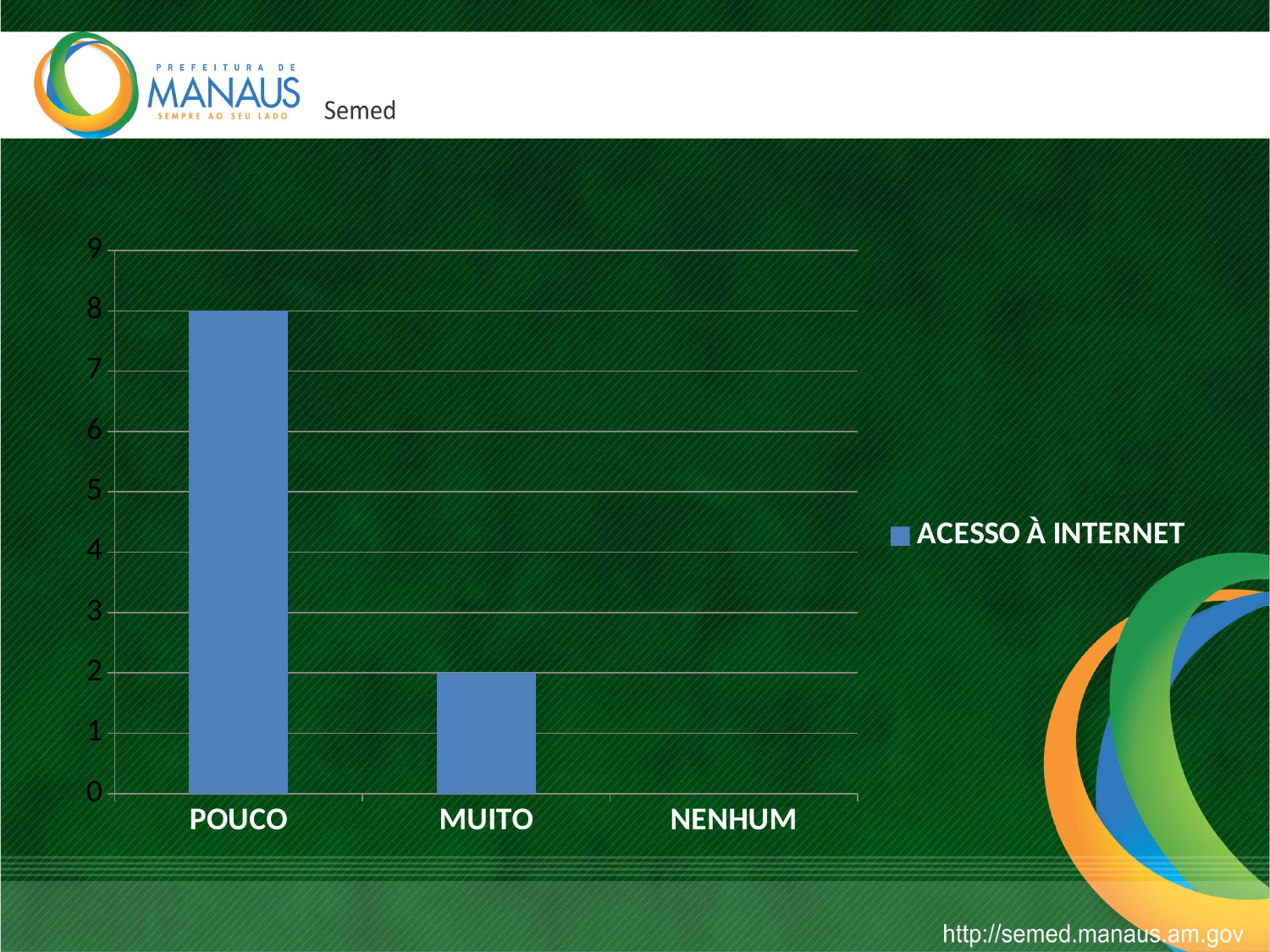
How many categories are shown on the x axis? 3 What kind of chart is shown on the slide? bar chart Which category has the lowest value? NENHUM Which is larger, the value for POUCO or the value for MUITO? POUCO How many series does the legend list? 1 Is the value for MUITO greater or less than 5? less What is the value for MUITO? 2 What is the value for POUCO? 8 Which category has the highest value? POUCO Is the value for POUCO greater or less than 5? greater What is the difference between the values for POUCO and MUITO? 6 What is the series name shown in the legend? ACESSO À INTERNET